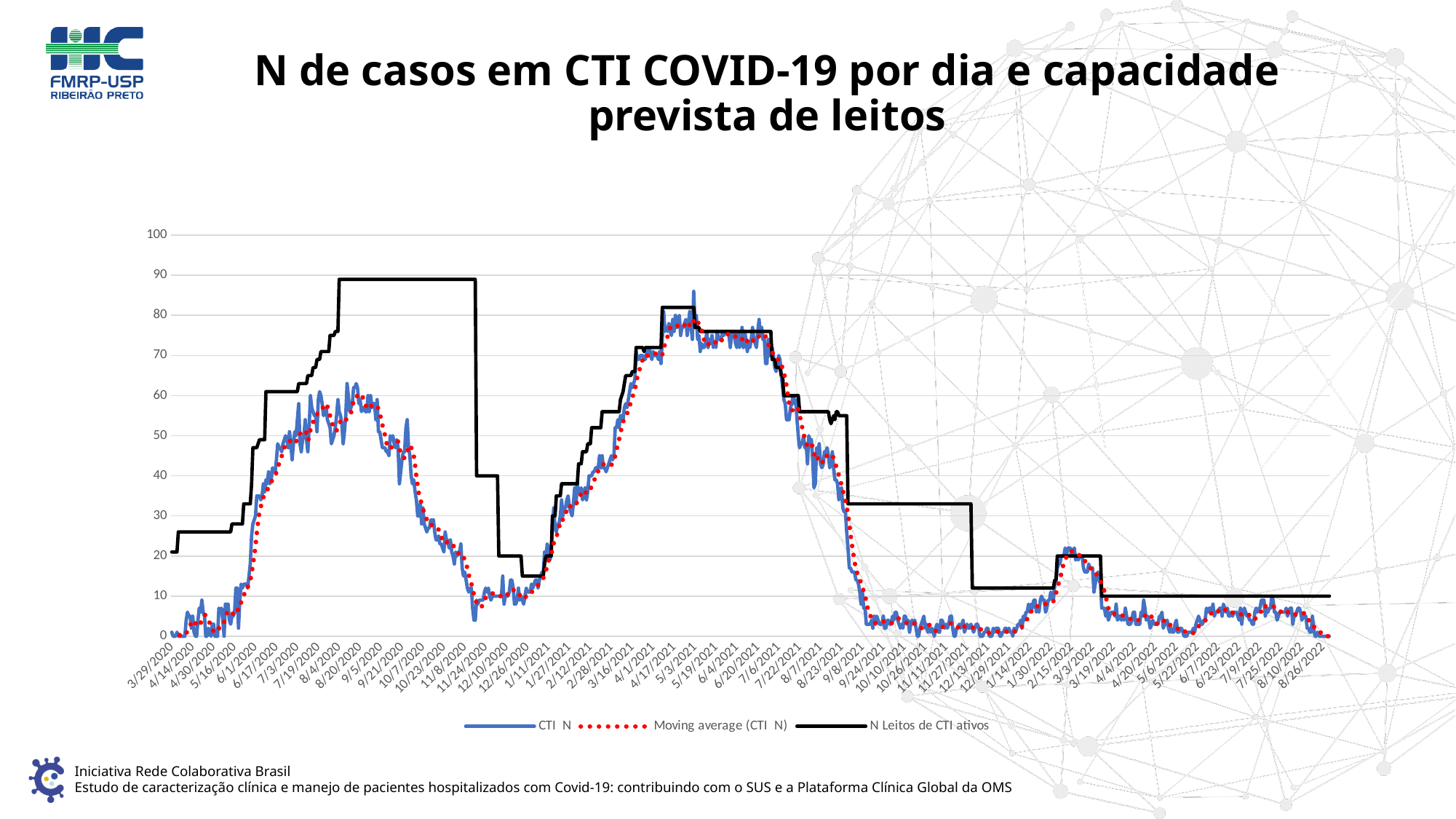
What is the highest value shown on the vertical axis? 100 Is the value of N Leitos de CTI ativos around 9/5/2020 greater or less than 80? greater What kind of chart is shown on the slide? line chart Is the value of CTI N around 10/10/2021 greater or less than 10? less Does the CTI N series rise or fall between 6/4/2021 and 9/8/2021? fall Does the CTI N series rise or fall between 3/29/2020 and 8/4/2020? rise Is the value of CTI N around 5/3/2021 greater or less than 70? greater How many series does the legend list? 3 What is the title of the chart? N de casos em CTI COVID-19 por dia e capacidade prevista de leitos Which series is drawn as a solid black line? N Leitos de CTI ativos